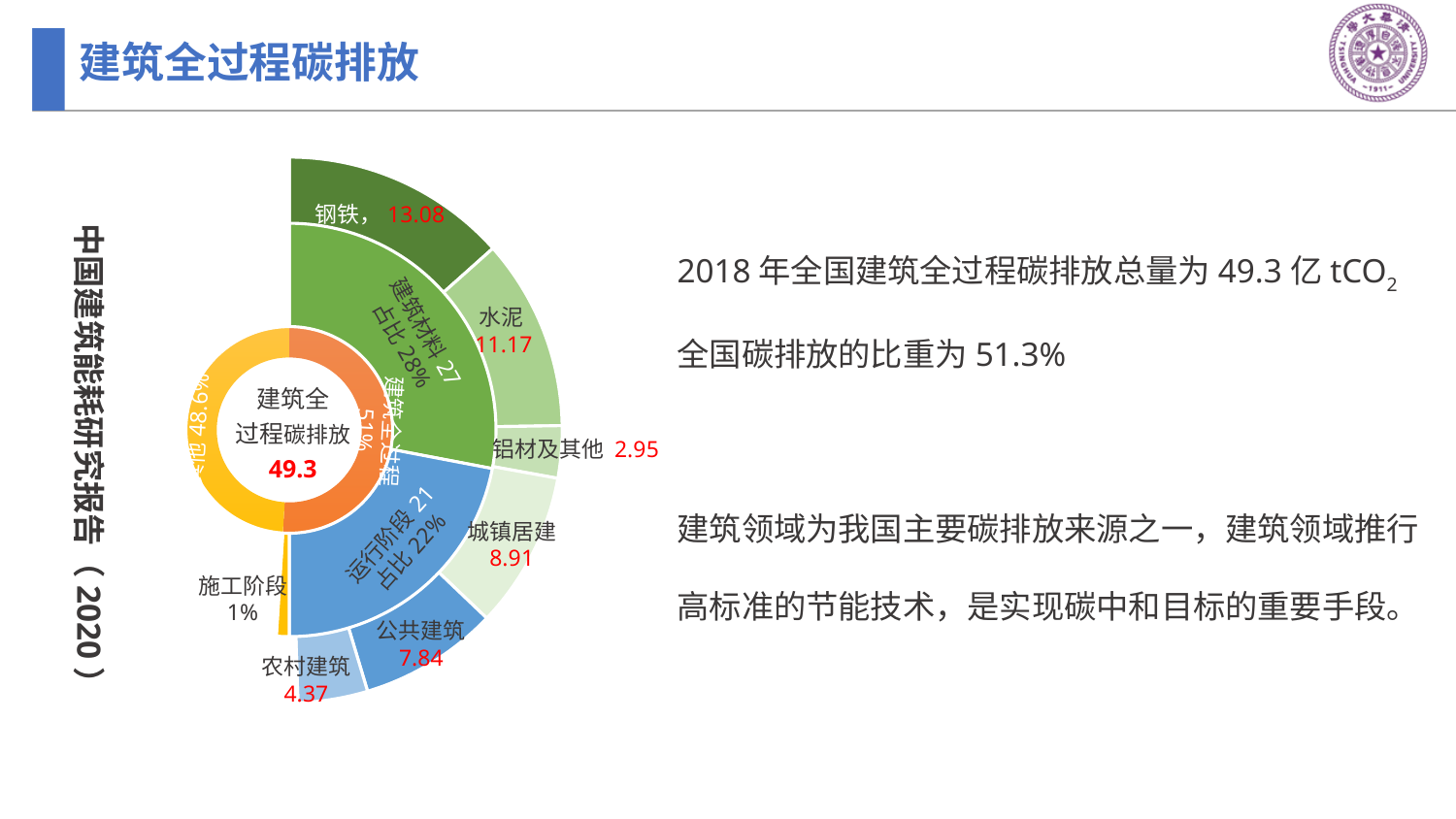
What percentage share is shown for 建筑材料 in the chart? 28% What kind of chart is shown on the slide? A donut (sunburst) chart Which segment in the outer ring of the chart has the highest value? 钢铁 What value is shown for 城镇居建 in the chart? 8.91 What value is shown for 农村建筑 in the chart? 4.37 What value is shown for 铝材及其他 in the chart? 2.95 Which has the larger value in the chart, 城镇居建 or 公共建筑? 城镇居建 What value is printed in the centre of the chart for 建筑全过程碳排放? 49.3 What value is shown for 钢铁 in the outer ring of the chart? 13.08 What value is shown for 水泥 in the chart? 11.17 Which segment in the outer ring of the chart has the lowest value? 铝材及其他 What is the difference between the values for 钢铁 and 水泥 in the chart? 1.91